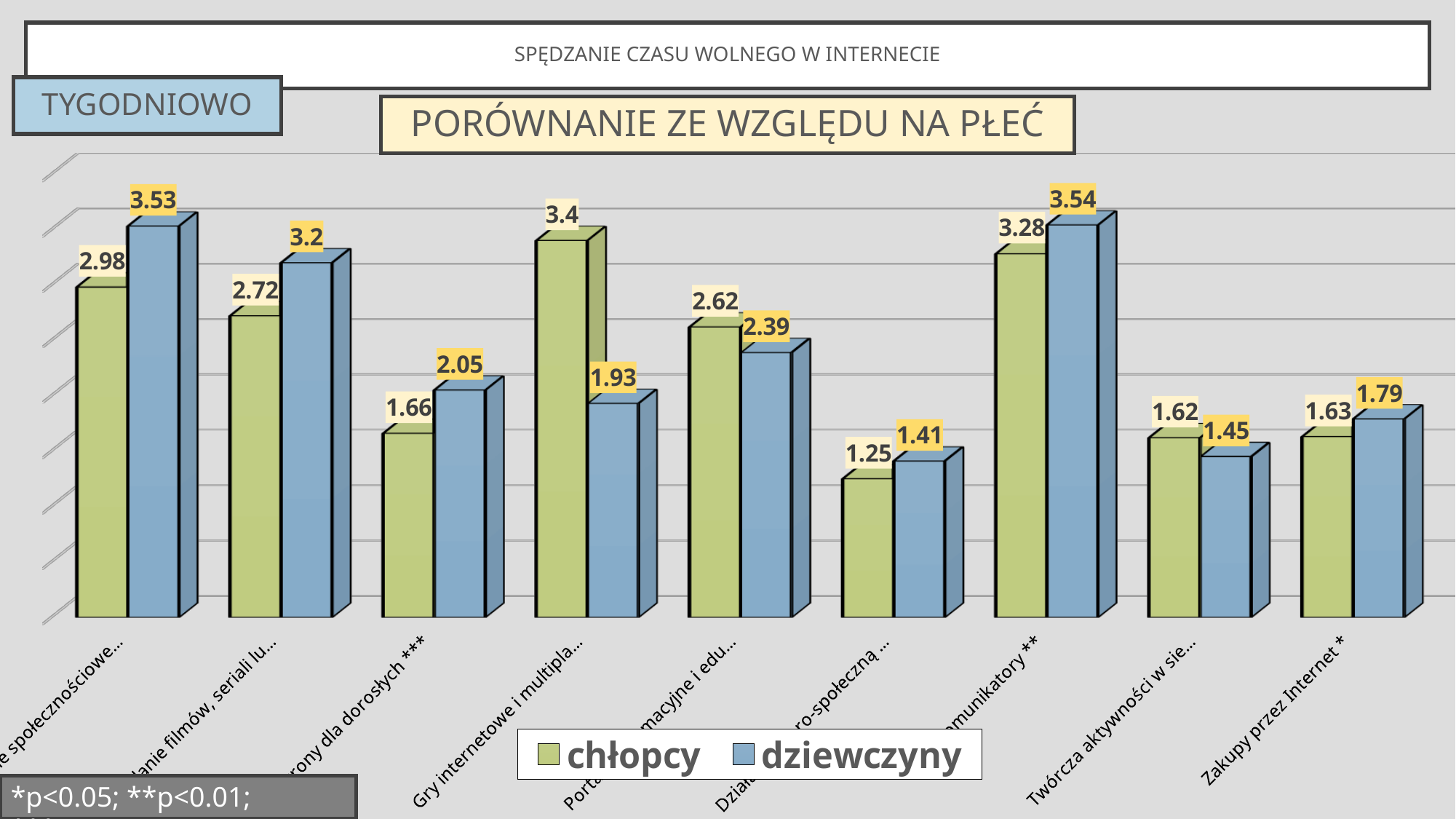
What is the value for dziewczyny in the category 'Zakupy przez Internet *'? 1.79 What kind of chart is shown on the slide? bar chart In which category is the value for chłopcy the highest? Gry internetowe i multipla... What is the lowest value for chłopcy shown on the chart? 1.25 How many categories are plotted on the chart? 9 What is the difference between dziewczyny and chłopcy in the category starting 'Gry internetowe i multipla...'? 1.47 What is the value for chłopcy in the category 'Zakupy przez Internet *'? 1.63 Which legend entry is shown in green? chłopcy How many series does the legend list? 2 What is the value for dziewczyny in the category ending '...komunikatory **'? 3.54 In the category starting 'Twórcza aktywności w sie...', which series has the larger value, chłopcy or dziewczyny? chłopcy What is the value for chłopcy in the category starting 'Gry internetowe i multipla...'? 3.4